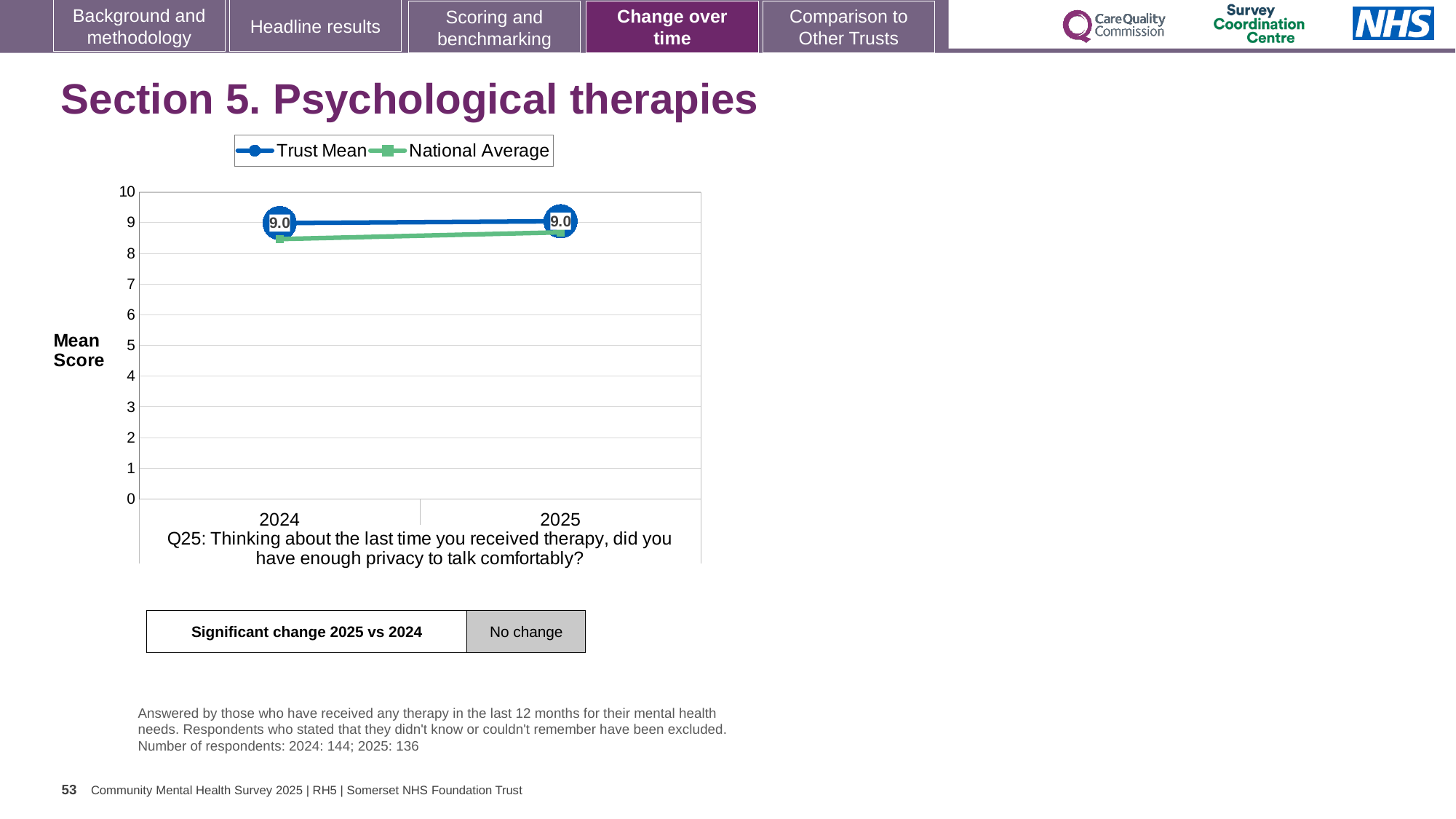
What are the two series named in the legend? Trust Mean and National Average What is the label on the y axis of the chart? Mean Score Is the National Average value for 2024 greater or less than 9? less Does the Trust Mean rise, fall or stay the same from 2024 to 2025? Stays the same What is the Trust Mean value for 2025? 9.0 Does the National Average rise or fall from 2024 to 2025? Rises What kind of chart is shown on the slide? Line chart What is the Trust Mean value for 2024? 9.0 How many series does the legend list? 2 How many years are plotted on the x axis? 2 In 2024, which is larger: the Trust Mean or the National Average? Trust Mean What is the difference between the Trust Mean values for 2025 and 2024? 0.0